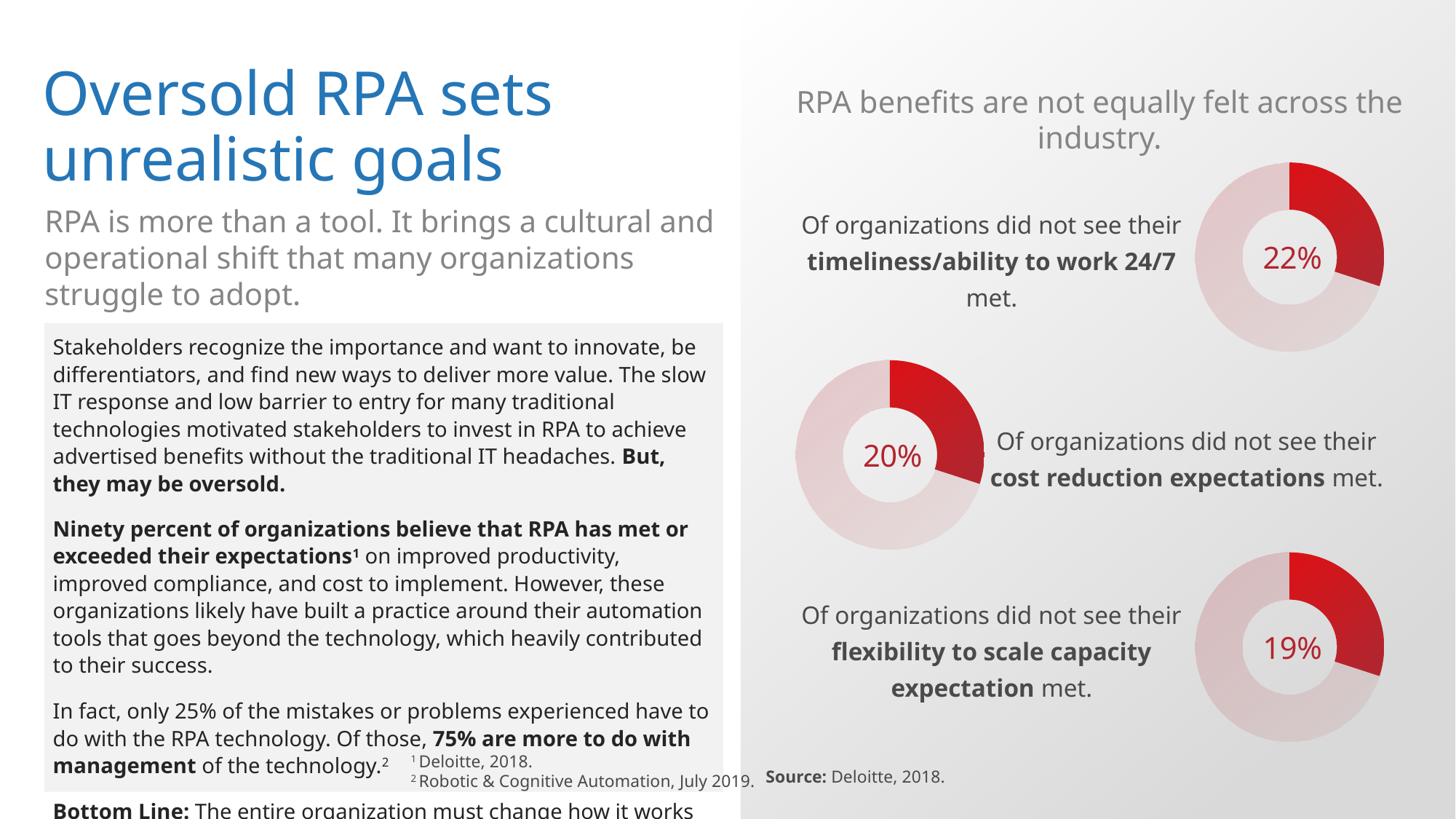
Which of the three donut charts on the right shows the lowest percentage? flexibility to scale capacity expectation (19%) What colour is the highlighted segment in each donut chart? red How many donut charts are shown on the right side of the slide? 3 What percentage of organizations did not see their timeliness/ability to work 24/7 expectation met, according to the top donut chart? 22% What is the difference between the percentage for timeliness/ability to work 24/7 and the percentage for flexibility to scale capacity expectation? 3% What percentage of organizations did not see their cost reduction expectations met, according to the middle donut chart? 20% Which is larger: the percentage for timeliness/ability to work 24/7 or the percentage for cost reduction expectations? timeliness/ability to work 24/7 What kind of chart is used to show the percentages on the right side of the slide? donut (pie) chart What percentage of organizations did not see their flexibility to scale capacity expectation met, according to the bottom donut chart? 19% Which of the three donut charts on the right shows the highest percentage? timeliness/ability to work 24/7 (22%) What is the difference between the percentage for cost reduction expectations and the percentage for flexibility to scale capacity expectation? 1% What is the heading above the donut charts on the right side of the slide? RPA benefits are not equally felt across the industry.